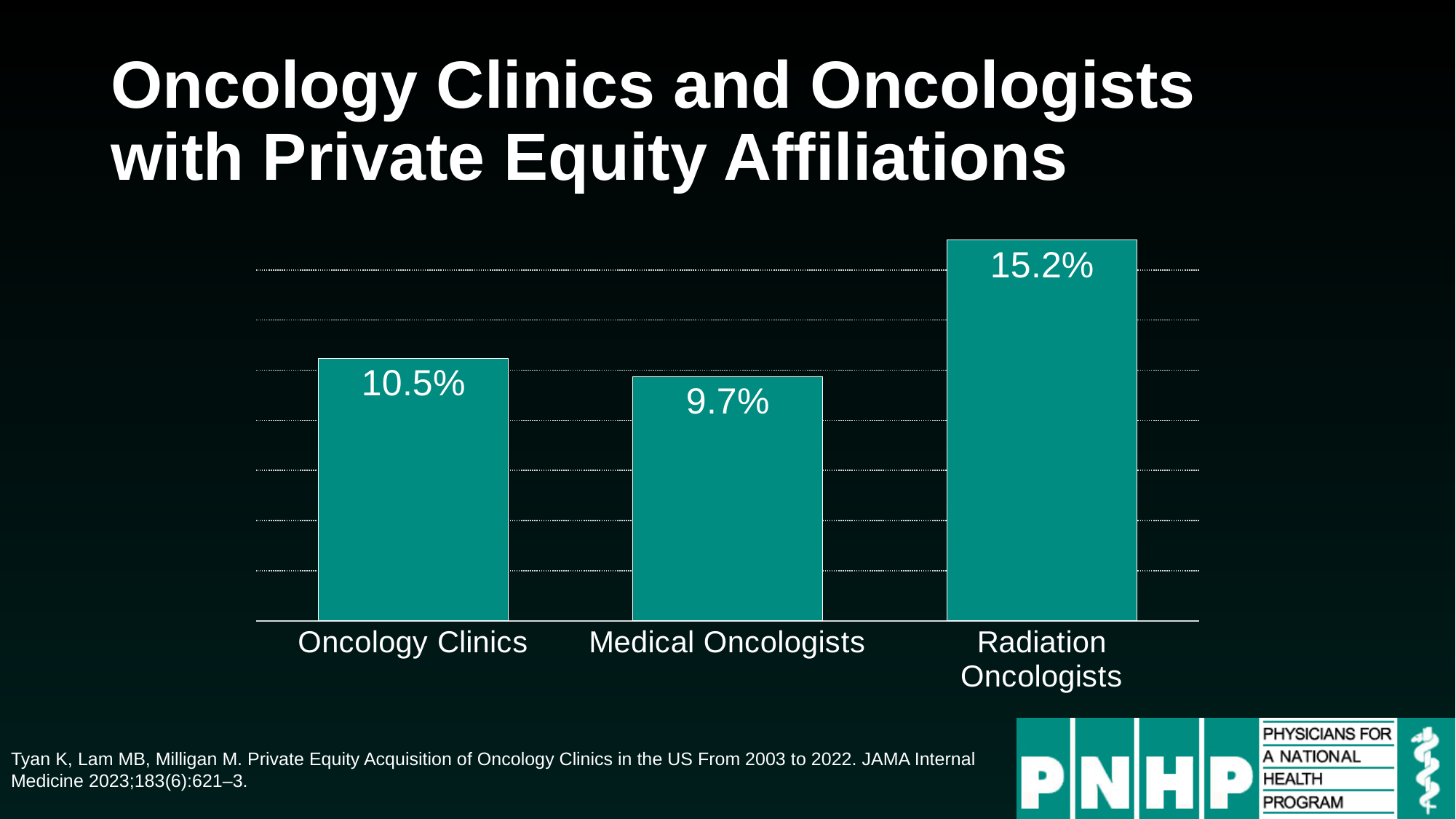
What is the difference between the values for Oncology Clinics and Medical Oncologists? 0.8% Which category has the lowest value? Medical Oncologists Which is larger, the value for Oncology Clinics or the value for Radiation Oncologists? Radiation Oncologists What colour are the bars in the chart? Teal What is the value shown for Medical Oncologists? 9.7% What is the difference between the values for Radiation Oncologists and Medical Oncologists? 5.5% What kind of chart is shown on the slide? Bar chart What percentage of Oncology Clinics have private equity affiliations? 10.5% How many categories are shown in the chart? 3 Which category has the highest value? Radiation Oncologists What is the value shown for Radiation Oncologists? 15.2% What is the title of the slide? Oncology Clinics and Oncologists with Private Equity Affiliations